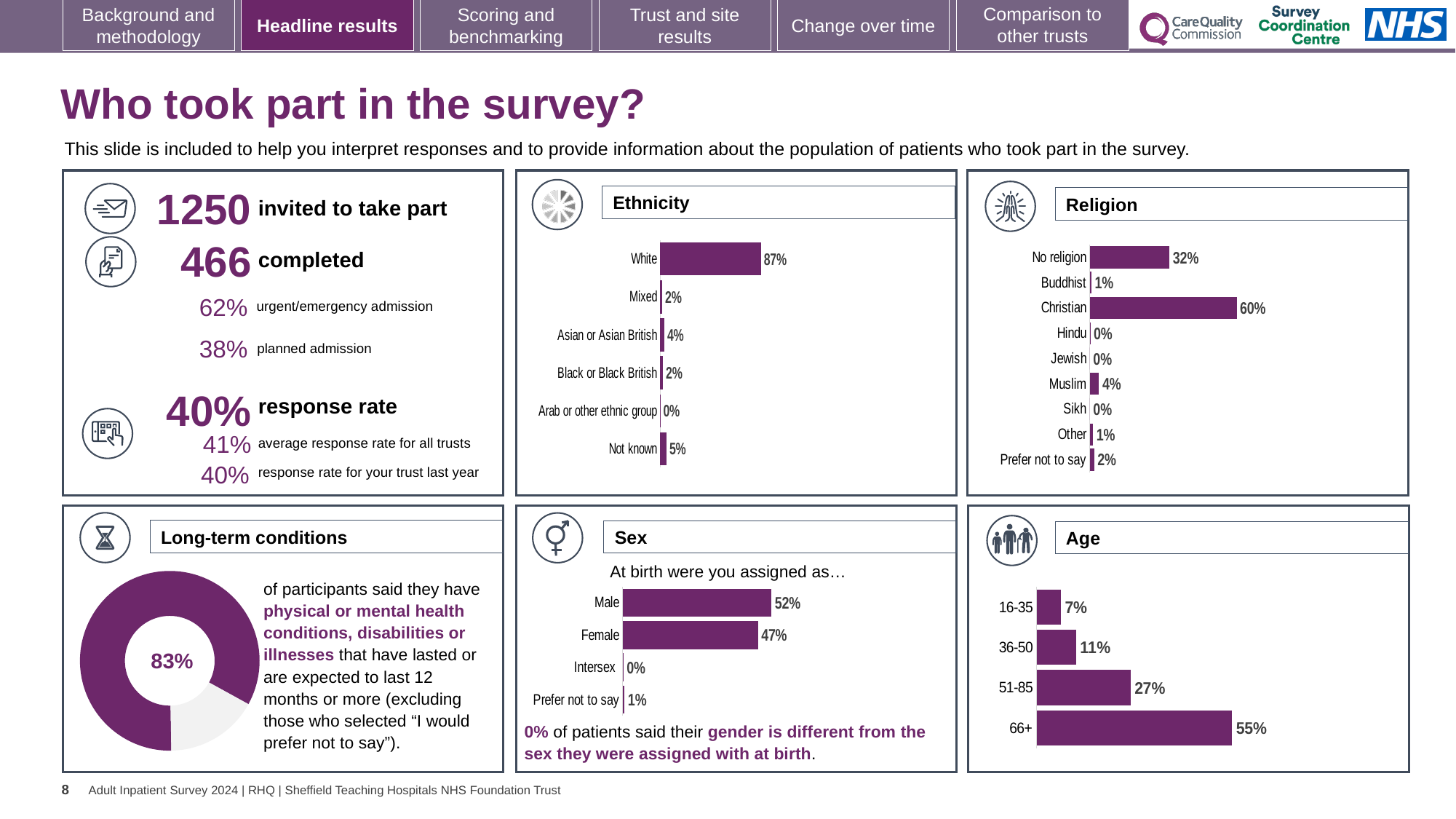
In the Age chart, what percentage of respondents were aged 66+? 55% In the Age chart, which age group has the lowest value? 16-35 In the Ethnicity chart, what percentage of respondents were White? 87% In the Religion chart, how many categories are shown? 9 In the Sex chart, which is larger, Male or Female? Male In the Ethnicity chart, which category has the highest value? White In the Religion chart, what percentage of respondents were Christian? 60% In the Ethnicity chart, how many categories are shown? 6 In the Age chart, do the values rise or fall as the age groups get older? rise What kind of chart is the Long-term conditions chart? doughnut chart In the Religion chart, what is the difference between the Christian and No religion values? 28% In the Sex chart, what percentage of respondents answered Prefer not to say? 1%